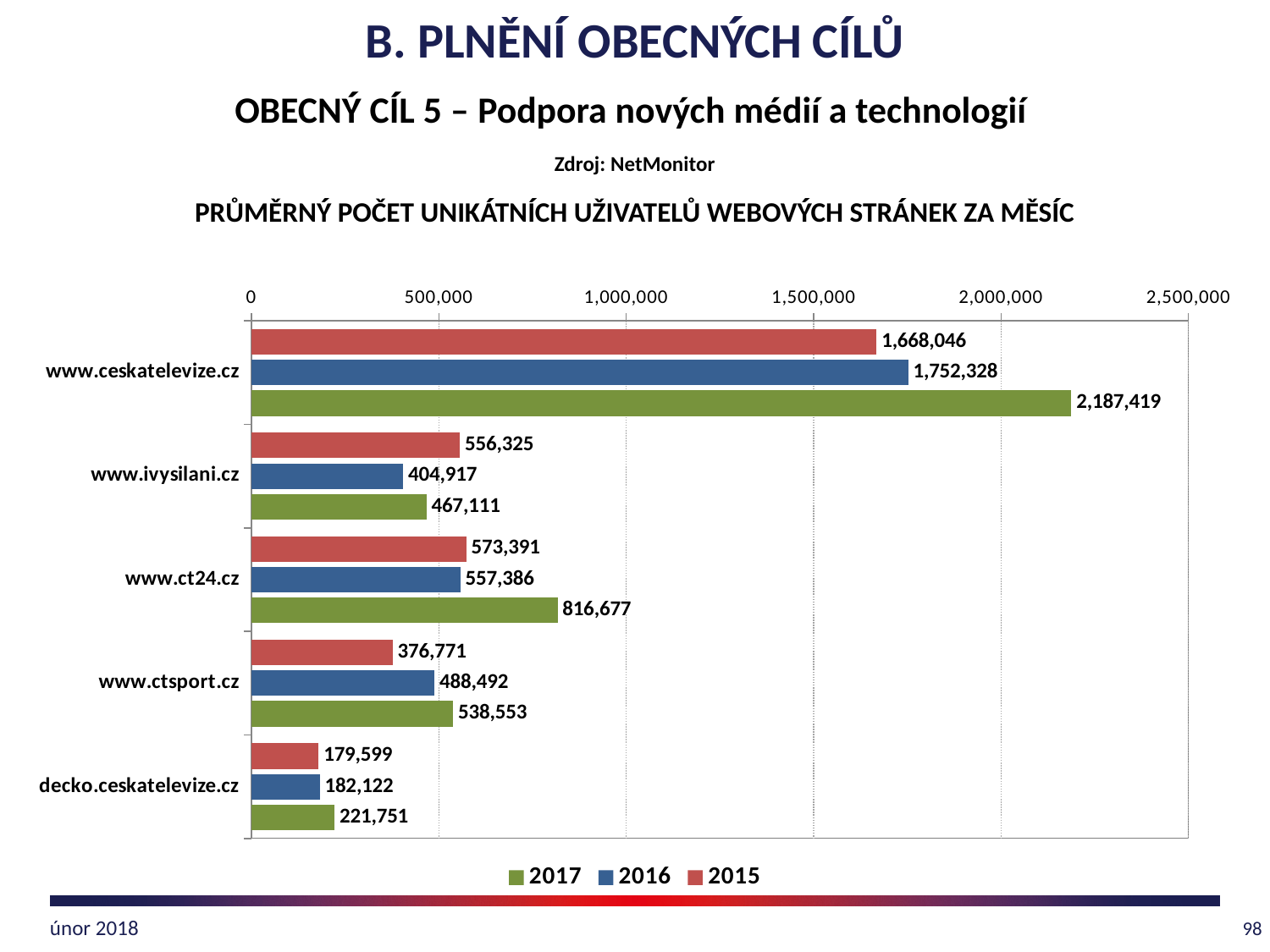
Which website has the lowest value in 2016? decko.ceskatelevize.cz Which is larger for www.ivysilani.cz: the 2015 value or the 2017 value? 2015 What is the value for decko.ceskatelevize.cz in 2015? 179,599 What is the value for www.ivysilani.cz in 2016? 404,917 Is the 2017 value for www.ctsport.cz greater or less than 500,000? greater Which colour represents 2016 in the legend? blue What kind of chart is shown on the slide? bar chart How many websites are shown on the chart? 5 What is the difference between the 2017 and 2016 values for www.ct24.cz? 259,291 How many series does the legend list? 3 What is the value for www.ceskatelevize.cz in 2017? 2,187,419 Which website has the highest value in 2017? www.ceskatelevize.cz